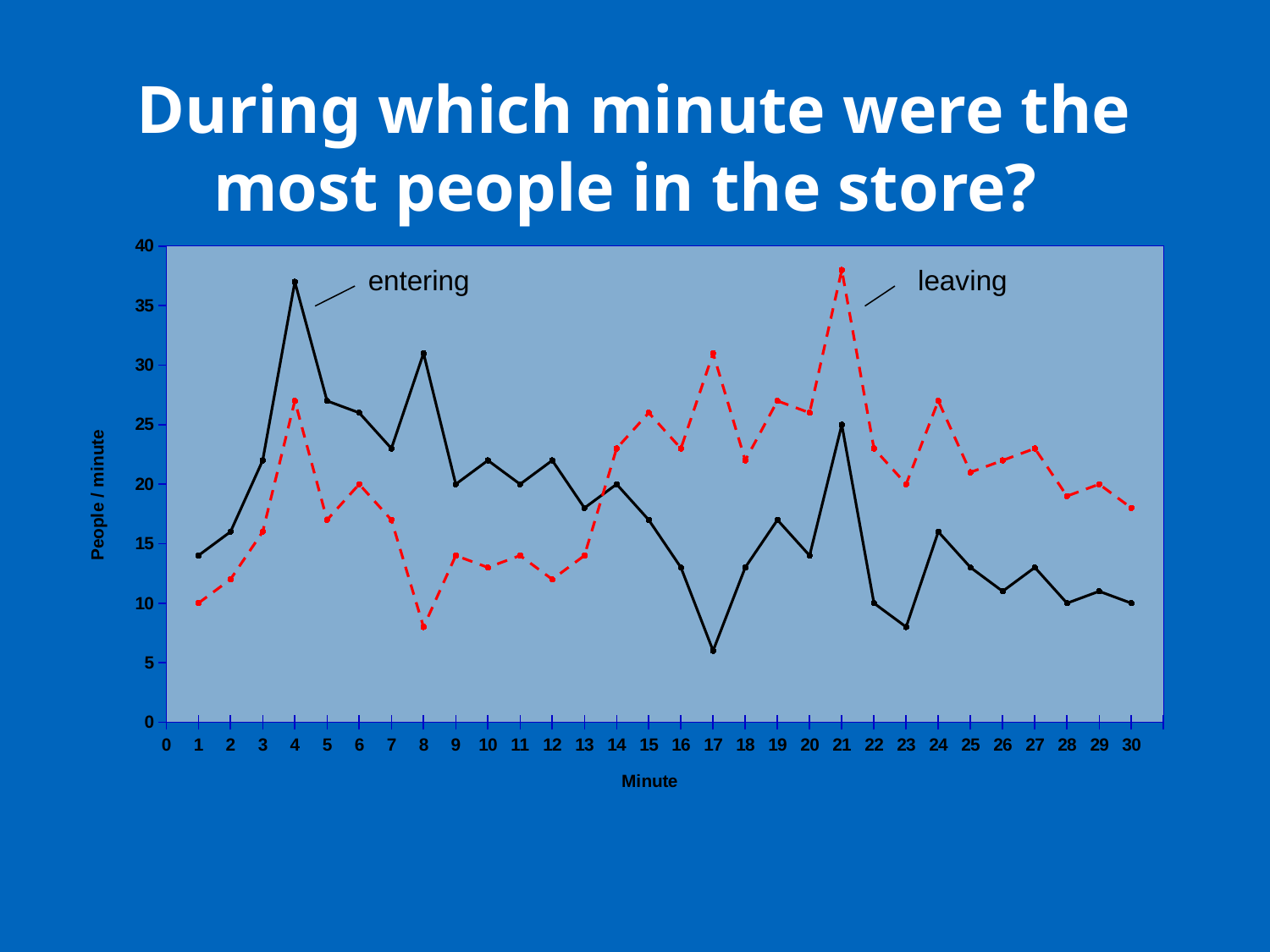
What are the two series plotted on the chart? entering and leaving What kind of chart is shown on the slide? line chart At minute 21, which series has the larger value, entering or leaving? leaving At which minute does the entering series reach its lowest value? 17 Is the value for entering at minute 4 greater or less than 35? greater At which minute does the leaving series reach its highest value? 21 How many minutes are plotted along the x axis for each series? 30 At which minute does the leaving series reach its lowest value? 8 At which minute does the entering series reach its highest value? 4 How many series are plotted on the chart? 2 Is the value for entering at minute 17 greater or less than 10? less Does the leaving series rise or fall from minute 1 to minute 4? rise